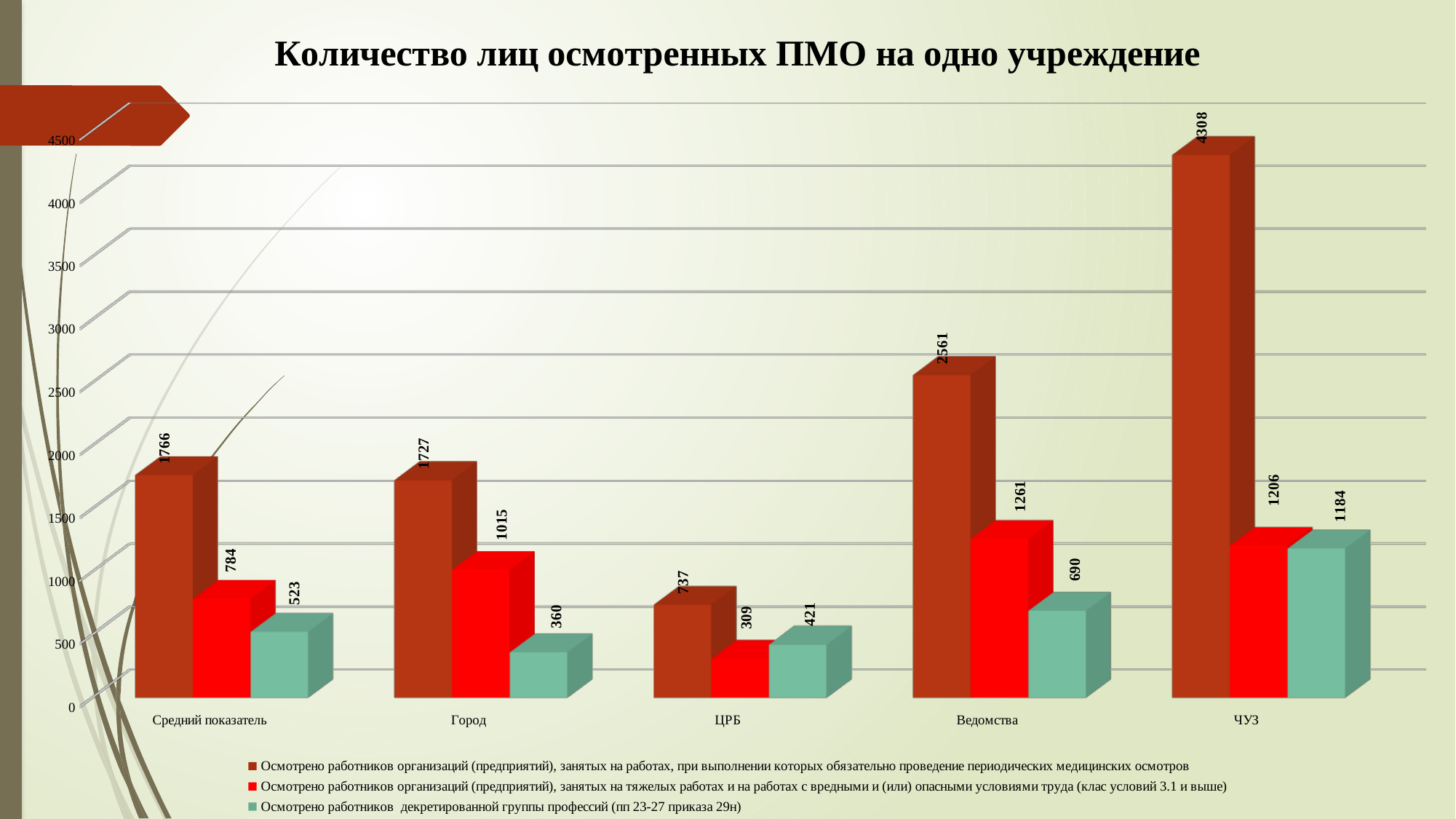
What type of chart is shown on the slide? bar chart What is the value of the red (second) series for Город? 1015 What is the value of the brown (first) series for ЧУЗ? 4308 Which category has the highest value in the brown (first) series? ЧУЗ What is the title of the chart? Количество лиц осмотренных ПМО на одно учреждение How many categories are shown on the x axis of the chart? 5 What is the difference between the brown (first) series values for Ведомства and Средний показатель? 795 What is the value of the teal (third) series for ЦРБ? 421 Which category has the lowest value in the red (second) series? ЦРБ How many series does the legend list? 3 Is the value of the brown (first) series for ЦРБ greater or less than 1000? less Which is larger: the teal (third) series value for Средний показатель or for Ведомства? Ведомства